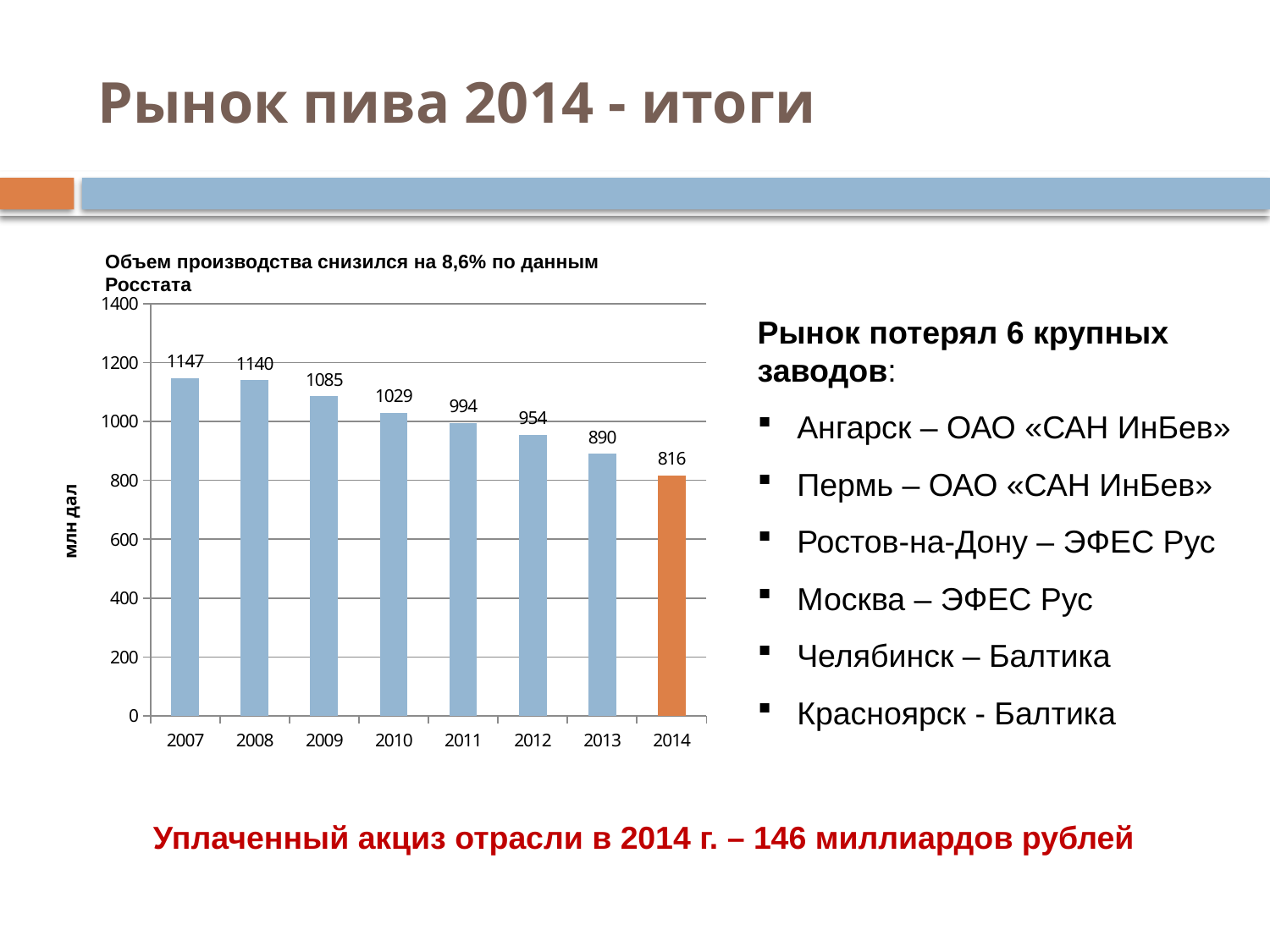
Which year has the highest value? 2007 What is the value for 2007? 1147 What is the difference between the values for 2013 and 2014? 74 Which year has the lowest value? 2014 What is the difference between the values for 2007 and 2014? 331 What is the label on the vertical axis? млн дал Do the values rise or fall from 2007 to 2014? fall What kind of chart is shown? bar chart Which is larger, the value for 2009 or the value for 2012? 2009 How many years are shown on the x axis? 8 What is the value for 2011? 994 What is the value for 2014? 816